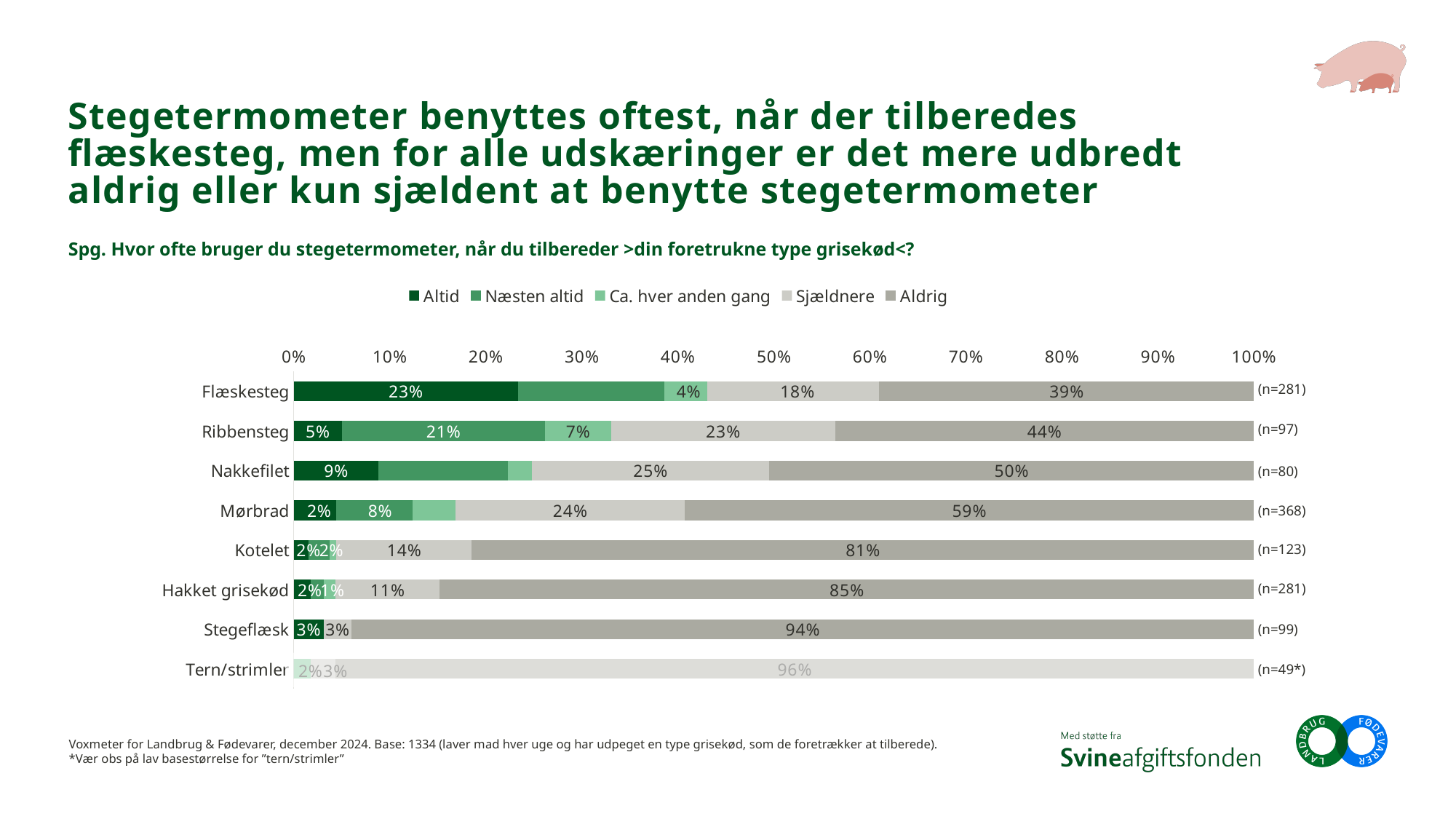
What is the "Altid" value for Flæskesteg? 23% What is the difference in percentage points between the "Aldrig" values for Hakket grisekød and Kotelet? 4 percentage points What is the "Altid" value for Nakkefilet? 9% Which category has the highest "Altid" share? Flæskesteg Which category has the highest "Aldrig" share? Tern/strimler Which has a larger "Aldrig" share, Mørbrad or Nakkefilet? Mørbrad What percentage of respondents answered "Aldrig" for Flæskesteg? 39% Which category has the lowest "Aldrig" share? Flæskesteg How many categories (types of pork) are shown in the chart? 8 Is the "Næsten altid" value for Flæskesteg greater or less than 10%? greater What is the "Sjældnere" value for Ribbensteg? 23% How many series does the legend list? 5